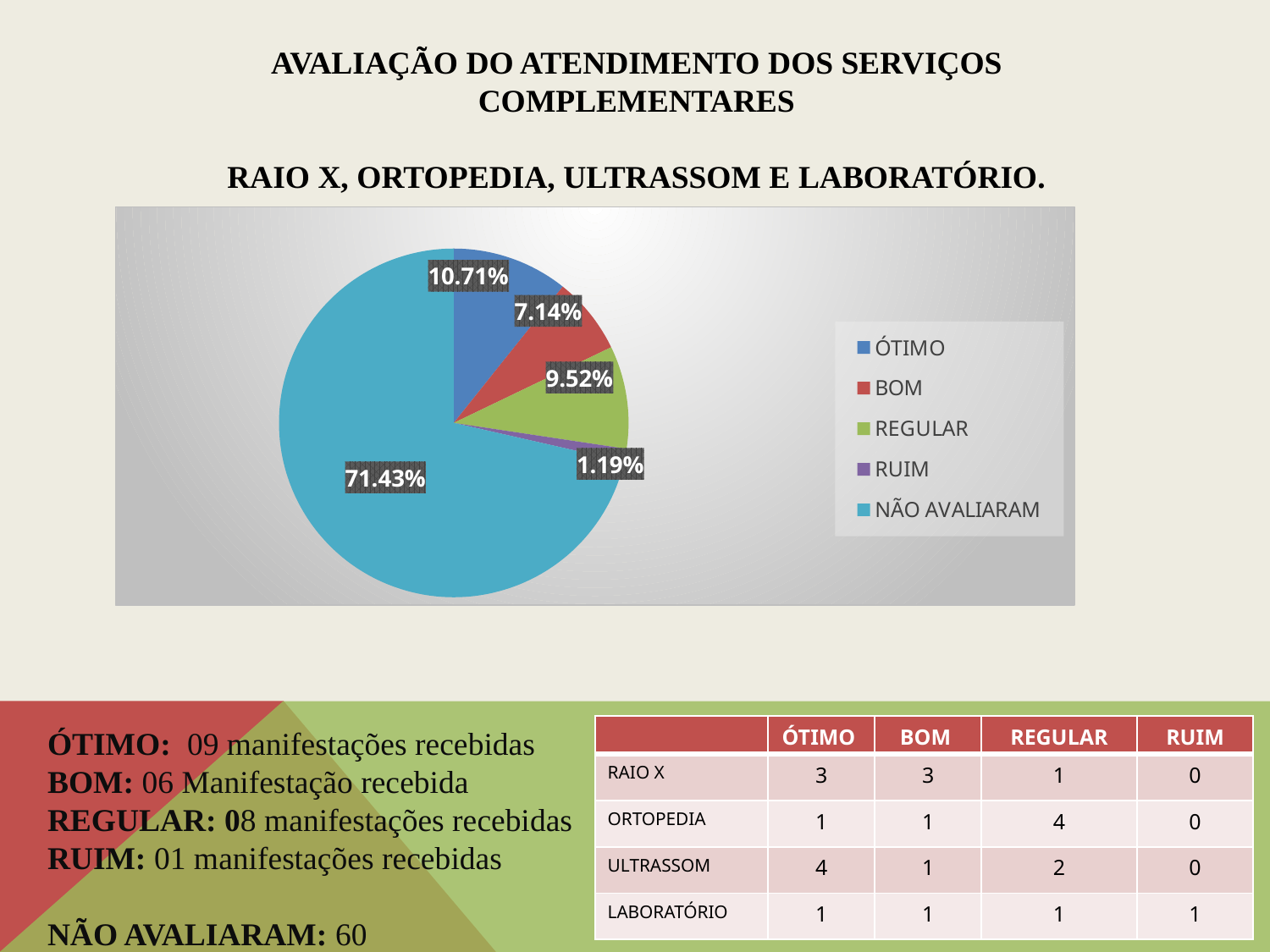
How many categories does the legend of the pie chart list? 5 What colour is the NÃO AVALIARAM slice in the pie chart? light blue What is the difference in percentage points between the ÓTIMO slice and the REGULAR slice? 1.19% Which category has the smallest slice of the pie? RUIM What share of the pie does NÃO AVALIARAM represent? 71.43% Which slice is larger, ÓTIMO or BOM? ÓTIMO What share of the pie does BOM represent? 7.14% What share of the pie does REGULAR represent? 9.52% What share of the pie does RUIM represent? 1.19% What share of the pie does ÓTIMO represent? 10.71% Which category has the largest slice of the pie? NÃO AVALIARAM What kind of chart is shown on the slide? pie chart